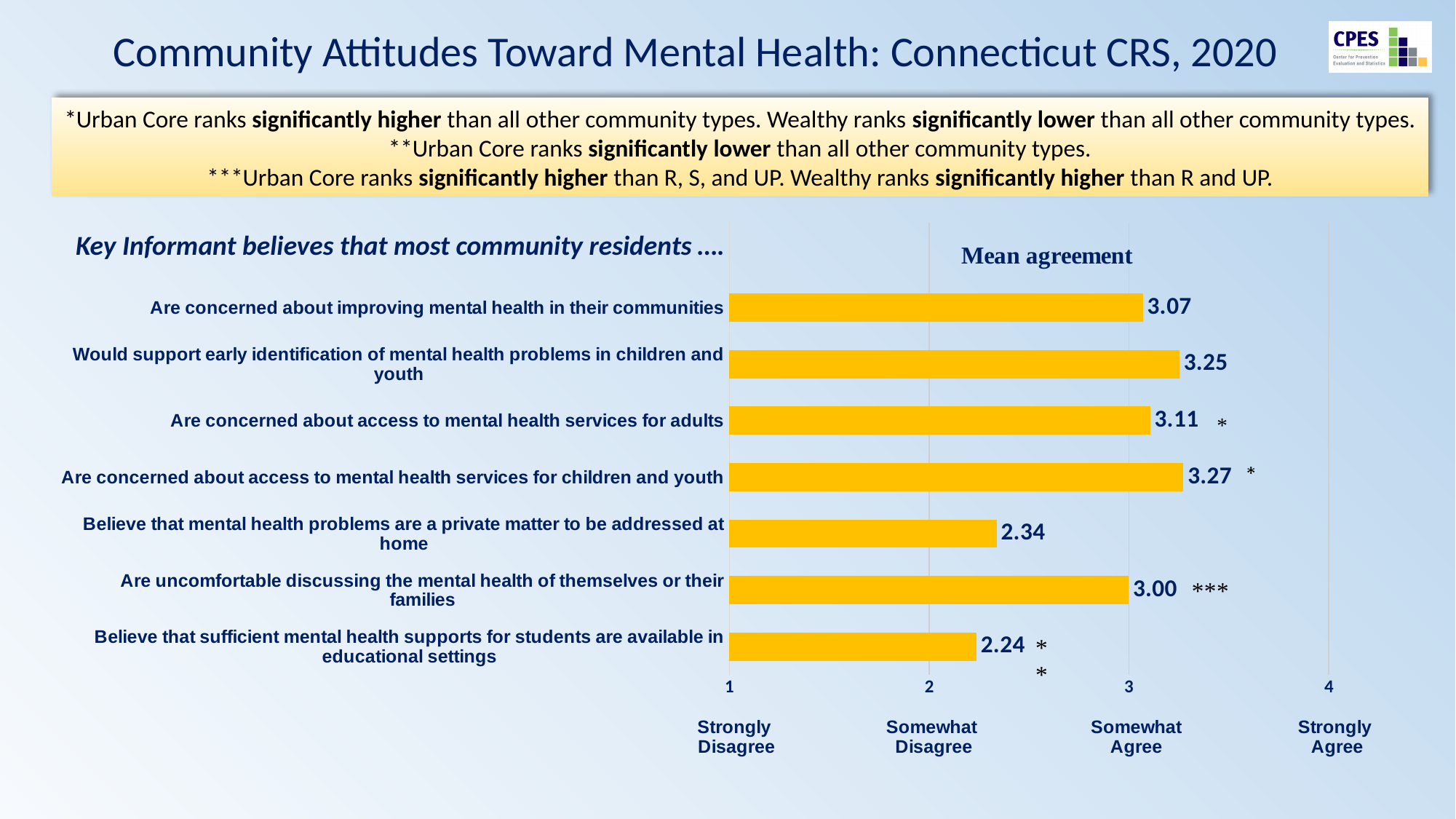
Which item has the lowest mean agreement? Believe that sufficient mental health supports for students are available in educational settings Which has a higher mean agreement: 'Would support early identification of mental health problems in children and youth' or 'Are concerned about improving mental health in their communities'? Would support early identification of mental health problems in children and youth What is the mean agreement for 'Would support early identification of mental health problems in children and youth'? 3.25 What is the difference in mean agreement between 'Are concerned about access to mental health services for children and youth' and 'Are concerned about access to mental health services for adults'? 0.16 What is the mean agreement for 'Believe that mental health problems are a private matter to be addressed at home'? 2.34 Is the mean agreement for 'Believe that mental health problems are a private matter to be addressed at home' greater or less than 3? less What is the mean agreement for 'Are concerned about improving mental health in their communities'? 3.07 What type of chart is shown on the slide? Bar chart Which item has the highest mean agreement? Are concerned about access to mental health services for children and youth How many items are plotted in the chart? 7 What label does the x axis show at the value 4? Strongly Agree What is the mean agreement for 'Are uncomfortable discussing the mental health of themselves or their families'? 3.00